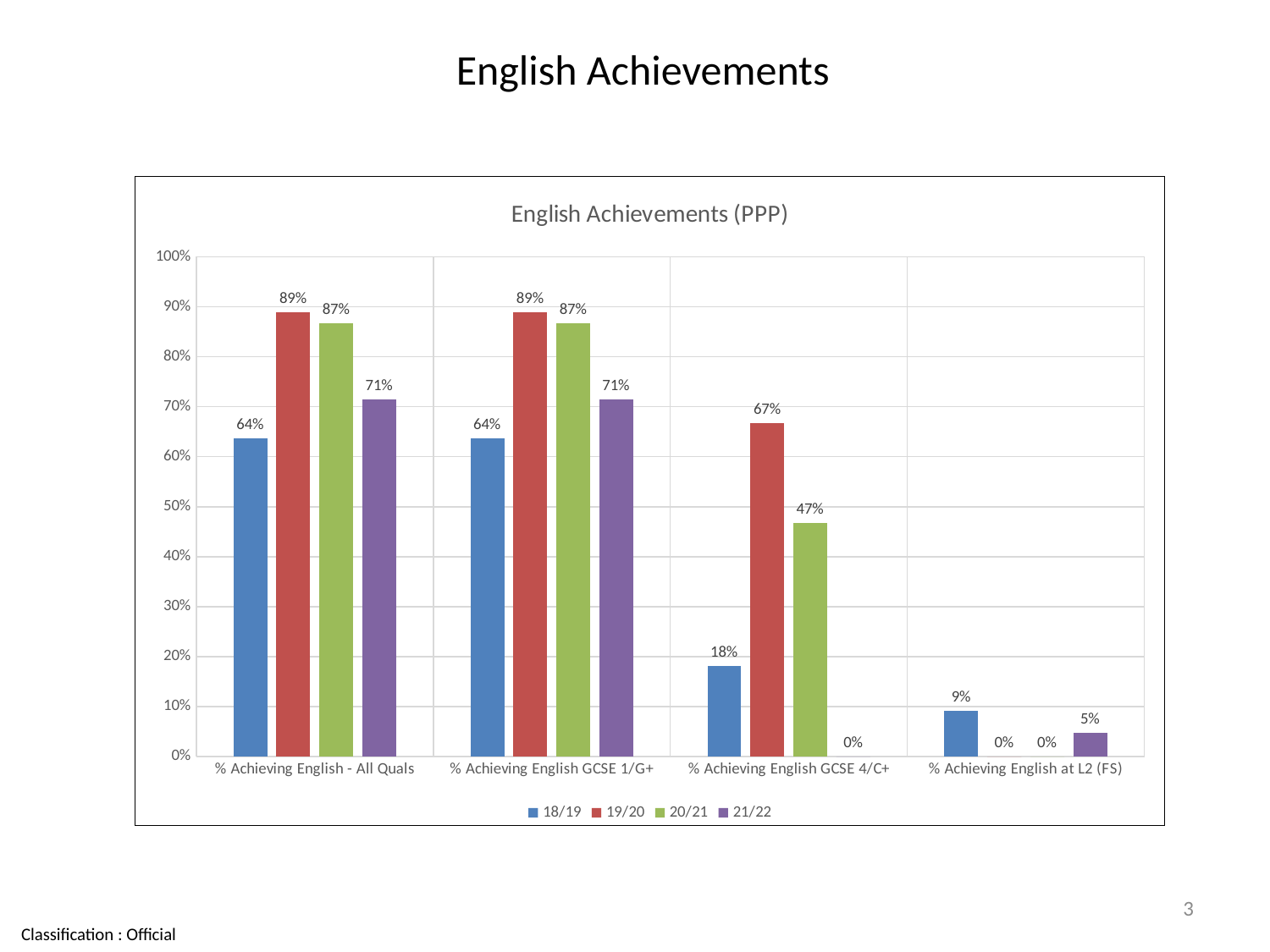
What is the 20/21 value for % Achieving English at L2 (FS)? 0% For % Achieving English GCSE 4/C+, which is larger: the 20/21 value or the 18/19 value? 20/21 Which series has the highest value for % Achieving English GCSE 1/G+? 19/20 What is the 18/19 value for % Achieving English at L2 (FS)? 9% What is the 19/20 value for % Achieving English GCSE 4/C+? 67% How many categories are shown on the x axis? 4 What is the difference between the 19/20 and 18/19 values for % Achieving English - All Quals? 25% What type of chart is shown on the slide? Bar chart What is the 21/22 value for % Achieving English - All Quals? 71% How many series does the legend list? 4 Which series has the lowest value for % Achieving English GCSE 4/C+? 21/22 What is the title of the chart? English Achievements (PPP)